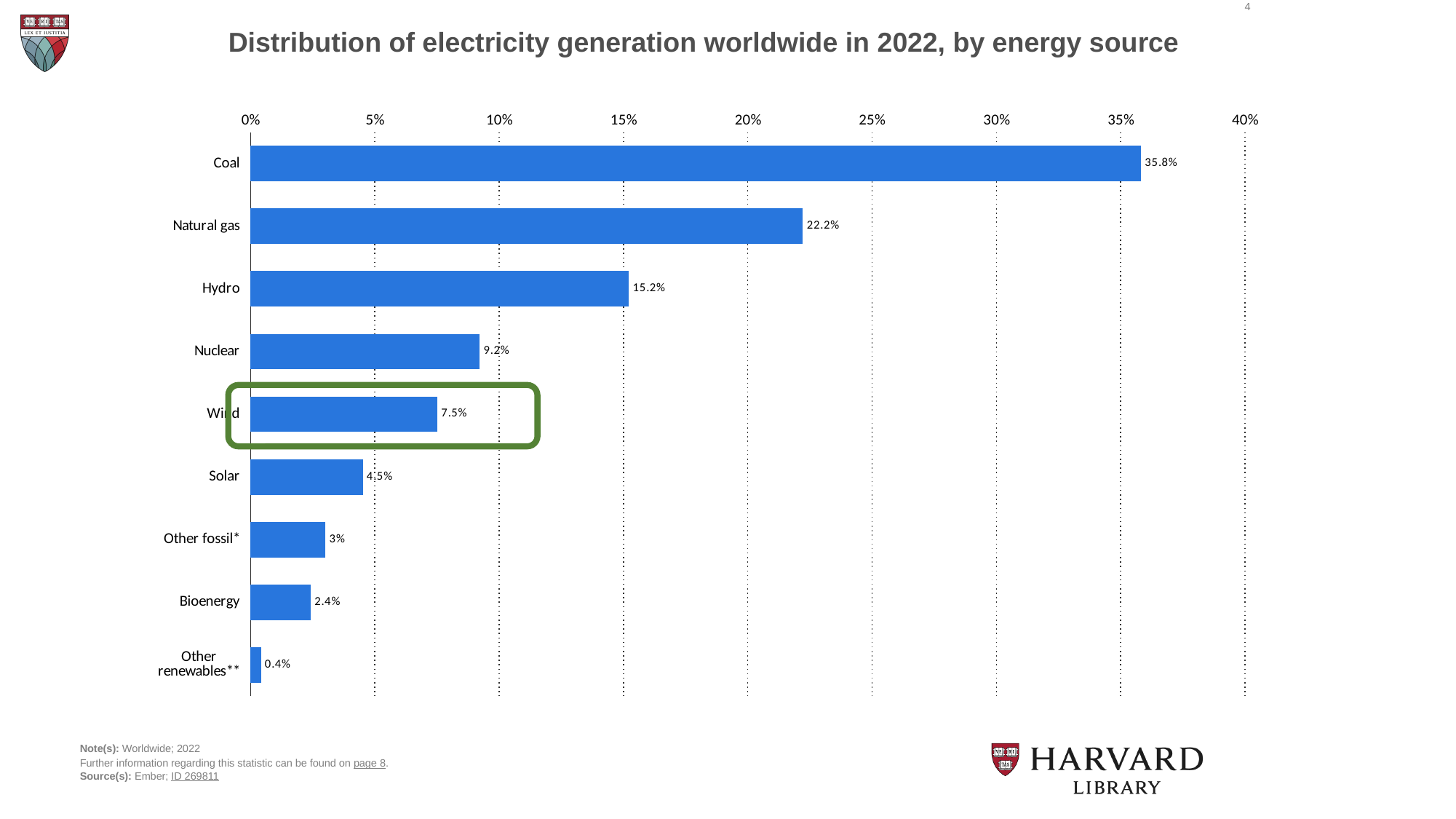
What share of worldwide electricity generation in 2022 came from coal? 35.8% What is the title of the chart? Distribution of electricity generation worldwide in 2022, by energy source Which energy source has the highest share of electricity generation? Coal What type of chart is shown on the slide? Bar chart How many energy sources are shown in the chart? 9 Is the value for Hydro greater or less than 20%? less What is the difference between the shares for Hydro and Nuclear? 6% What is the value shown for Natural gas? 22.2% Which energy source has the lowest share of electricity generation? Other renewables** Which has a larger share, Solar or Other fossil*? Solar What is the difference between the shares for Coal and Natural gas? 13.6% What percentage is shown for Wind? 7.5%